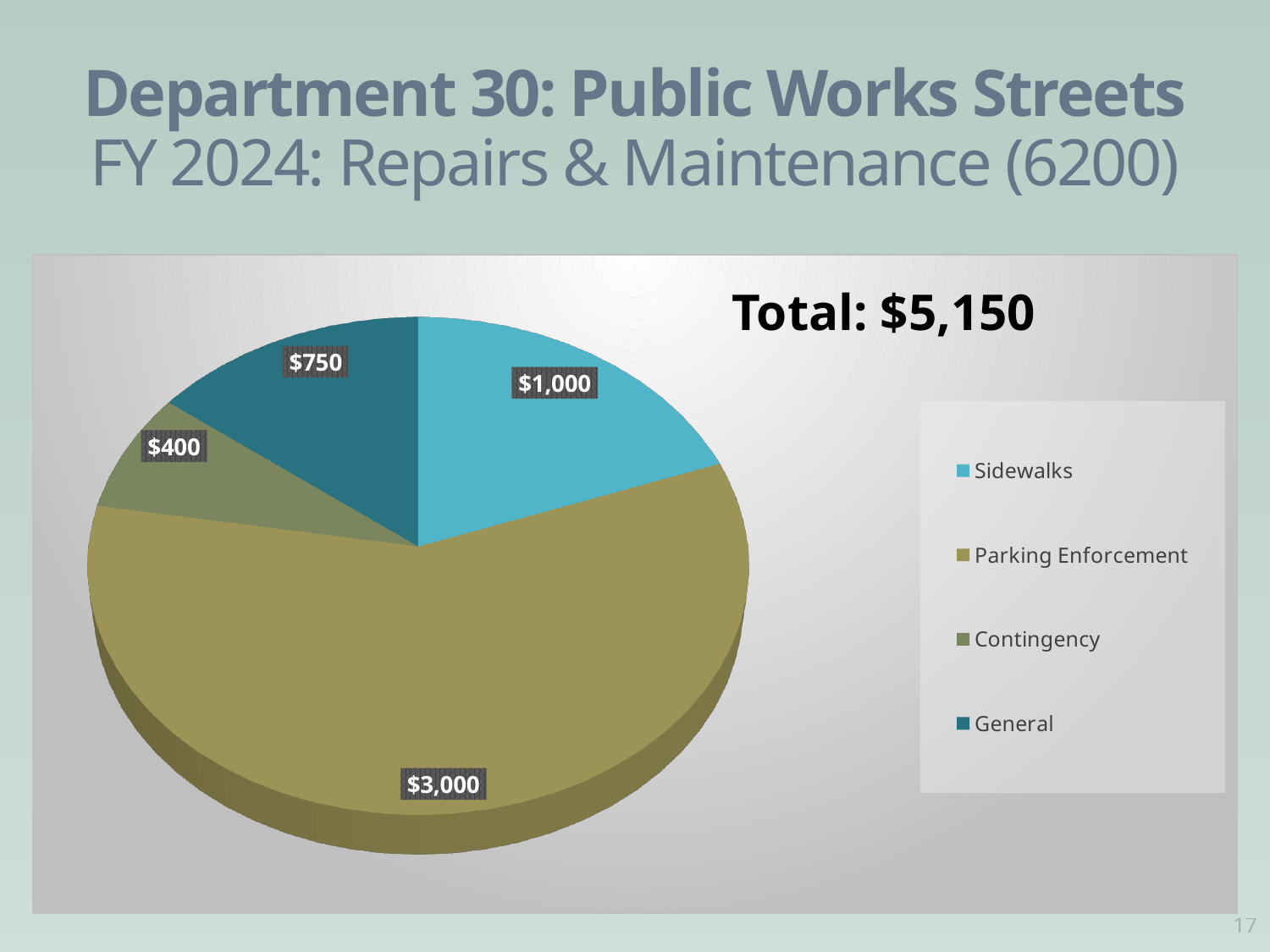
What is the value of the Contingency slice? $400 What is the difference between the Parking Enforcement and Sidewalks values? $2,000 What is the value of the General slice? $750 What is the value of the Parking Enforcement slice? $3,000 How many categories does the pie chart show? 4 Which category has the smallest slice of the pie? Contingency What is the value of the Sidewalks slice? $1,000 What kind of chart is shown on the slide? Pie chart What total is printed on the chart? $5,150 What is the difference between the General and Contingency values? $350 Which category has the largest slice of the pie? Parking Enforcement Which is larger, the Sidewalks slice or the General slice? Sidewalks